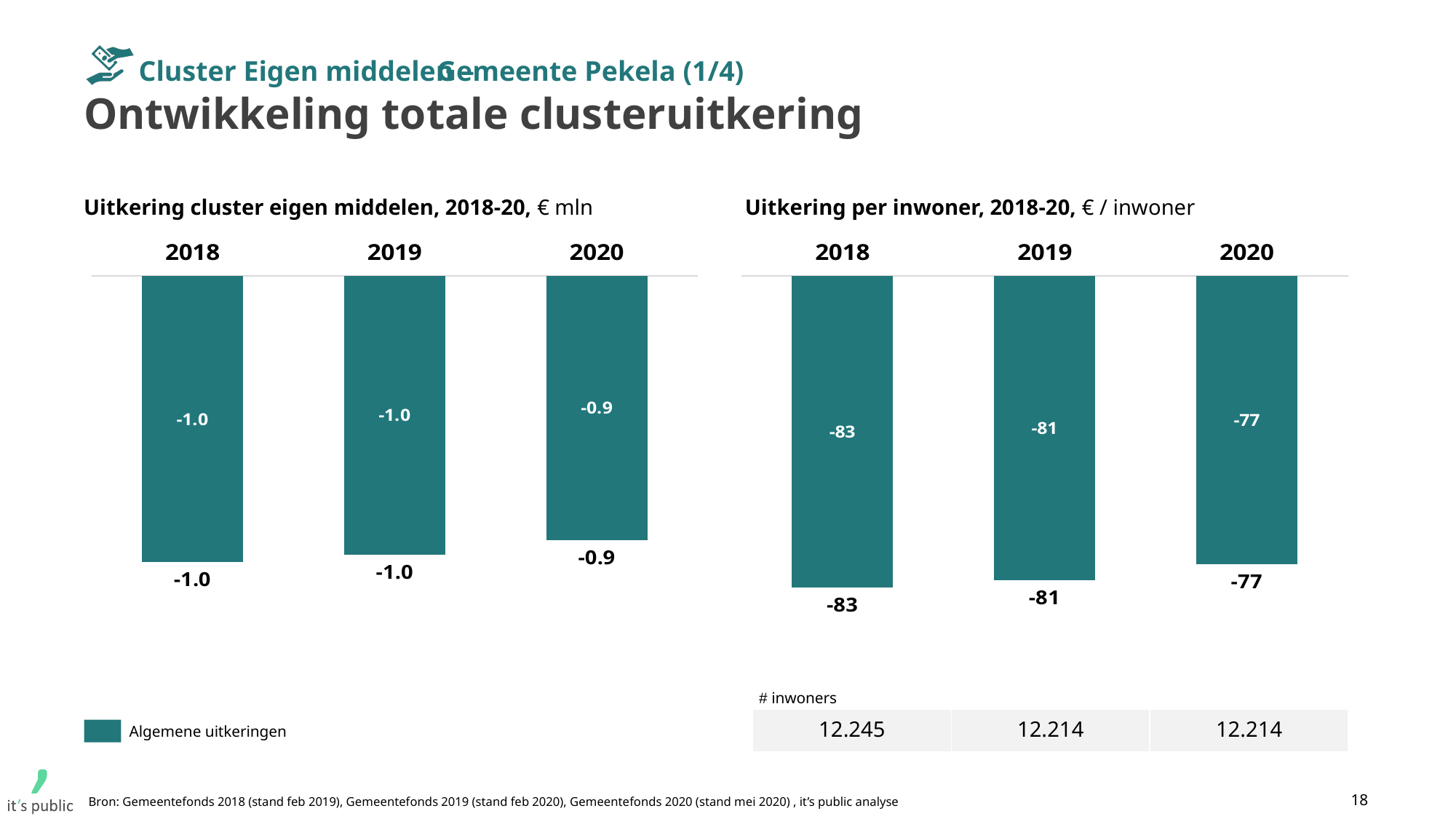
In the chart 'Uitkering cluster eigen middelen, 2018-20', what is the value for 2020? -0.9 In the chart 'Uitkering per inwoner, 2018-20', what is the value for 2020? -77 In the chart 'Uitkering cluster eigen middelen, 2018-20', what is the difference between the values for 2018 and 2020? 0.1 How many years are shown in the chart 'Uitkering cluster eigen middelen, 2018-20'? 3 In the chart 'Uitkering per inwoner, 2018-20', is the value for 2019 larger or smaller than the value for 2018? larger In the chart 'Uitkering cluster eigen middelen, 2018-20', what is the value for 2019? -1.0 In the chart 'Uitkering per inwoner, 2018-20', which year has the lowest (most negative) value? 2018 In the chart 'Uitkering per inwoner, 2018-20', do the values rise or fall from 2018 to 2020? rise In the chart 'Uitkering per inwoner, 2018-20', what is the value for 2018? -83 In the chart 'Uitkering per inwoner, 2018-20', which year has the highest value? 2020 In the chart 'Uitkering per inwoner, 2018-20', what is the difference between the values for 2018 and 2020? 6 What kind of chart is 'Uitkering per inwoner, 2018-20'? bar chart